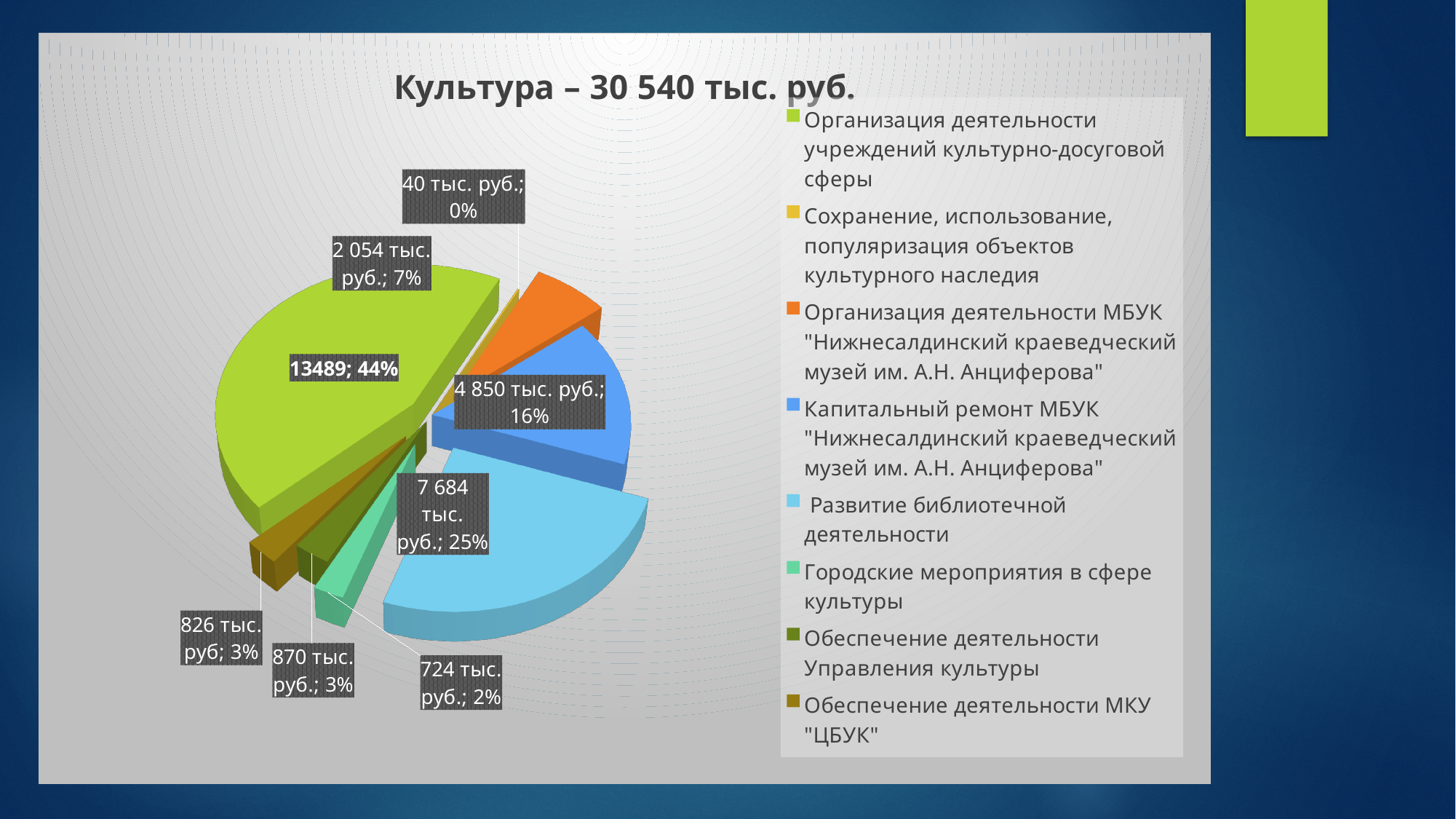
How many slices does the pie chart have? 8 What is the difference between the value for "Развитие библиотечной деятельности" (7 684 тыс. руб.) and the value for "Капитальный ремонт МБУК" (4 850 тыс. руб.)? 2 834 тыс. руб. What percentage share does "Организация деятельности МБУК "Нижнесалдинский краеведческий музей им. А.Н. Анциферова"" have? 7% What is the title of the chart? Культура – 30 540 тыс. руб. Which category has the largest slice of the pie? Организация деятельности учреждений культурно-досуговой сферы What is the value shown for "Городские мероприятия в сфере культуры"? 724 тыс. руб. What is the value shown for "Капитальный ремонт МБУК "Нижнесалдинский краеведческий музей им. А.Н. Анциферова""? 4 850 тыс. руб. What kind of chart is shown on the slide? Pie chart What percentage share does "Развитие библиотечной деятельности" have in the pie? 25% Which category has the smallest slice of the pie? Сохранение, использование, популяризация объектов культурного наследия How many entries does the legend list? 8 Which is larger: the slice for "Капитальный ремонт МБУК" or the slice for "Развитие библиотечной деятельности"? Развитие библиотечной деятельности